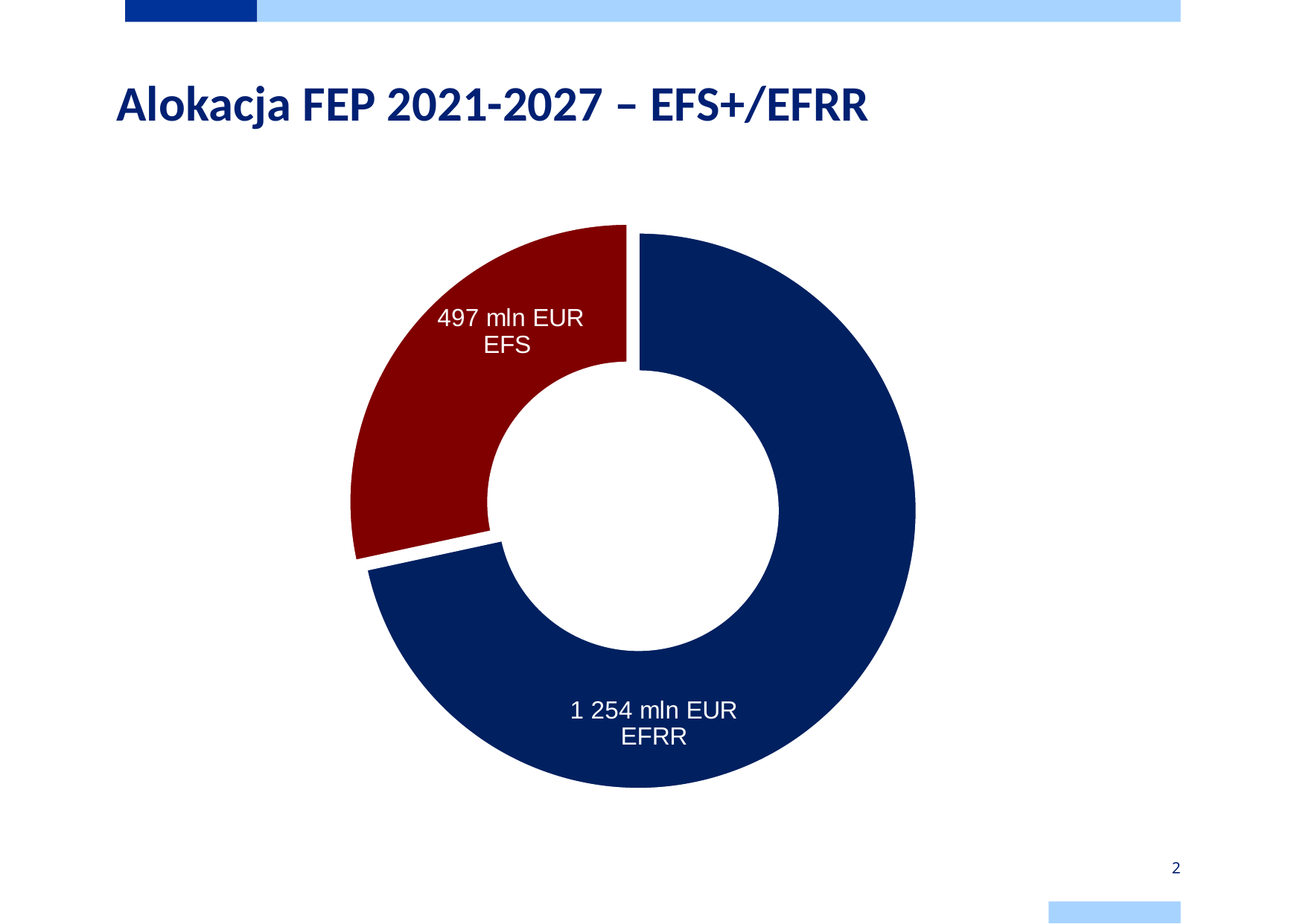
What kind of chart is shown on the slide? Pie (doughnut) chart What is the title of the slide containing the chart? Alokacja FEP 2021-2027 – EFS+/EFRR What colour is the EFS slice of the chart? Red Which is larger, the EFS allocation or the EFRR allocation? EFRR Which category has the smallest allocation on the chart? EFS How many categories are shown on the chart? 2 What is the difference between the EFRR and EFS allocations? 757 mln EUR What is the value shown for EFS on the chart? 497 mln EUR What is the value shown for EFRR on the chart? 1 254 mln EUR What is the total of the two allocations shown on the chart? 1 751 mln EUR Which category has the largest allocation on the chart? EFRR